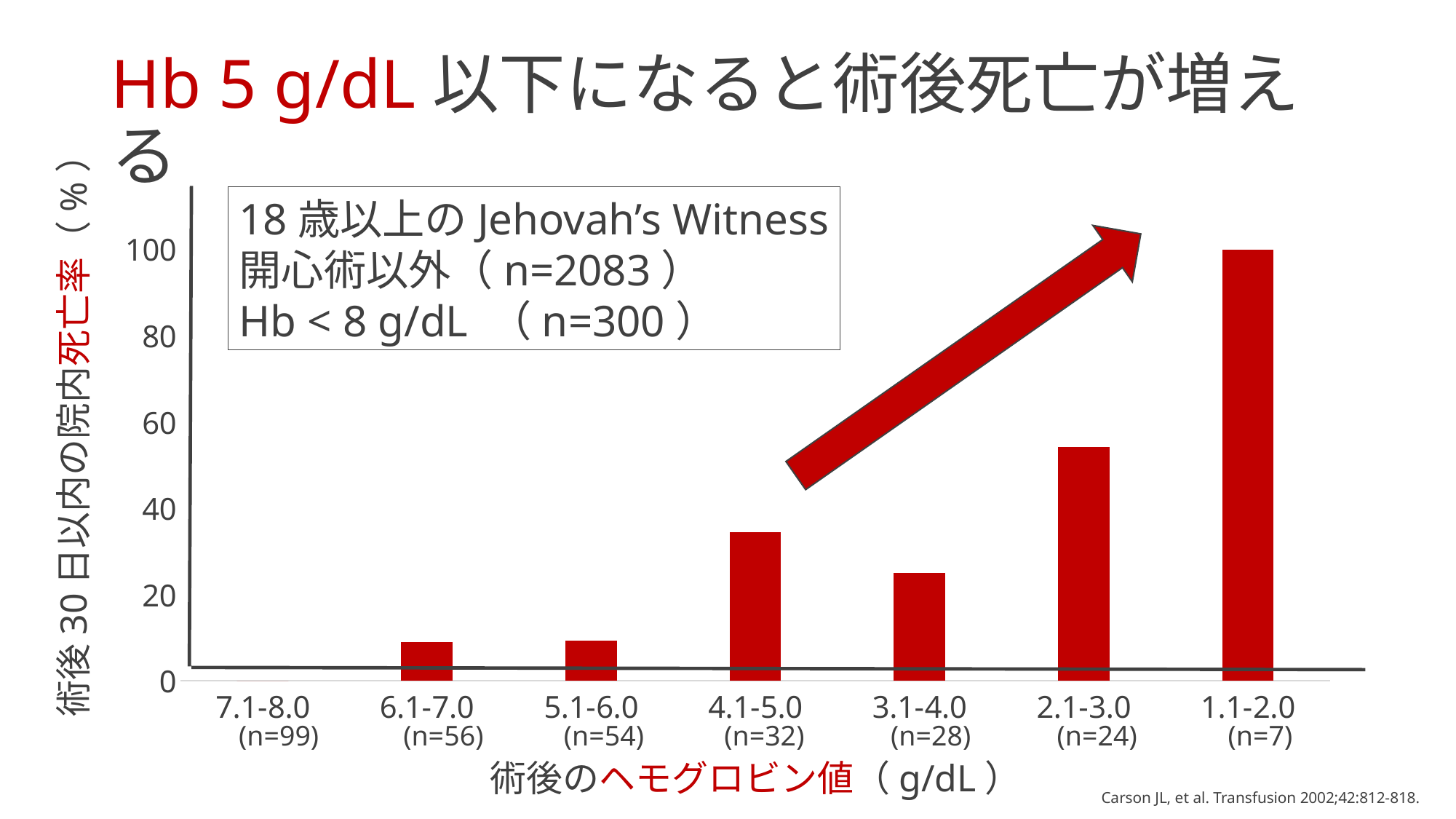
How many hemoglobin categories are shown on the x axis? 7 Which hemoglobin category has the lowest mortality rate? 7.1-8.0 What is the mortality rate (%) for the 1.1-2.0 g/dL category? 100 Is the mortality rate for the 6.1-7.0 category greater or less than 20? less How many patients (n) are in the 1.1-2.0 g/dL category? n=7 Is the mortality rate for the 2.1-3.0 category greater or less than 40? greater Do the mortality rates generally rise or fall moving from left to right along the x axis? rise Which hemoglobin category has the highest mortality rate? 1.1-2.0 What kind of chart is shown on the slide? bar chart What is the source cited for the chart? Carson JL, et al. Transfusion 2002;42:812-818. Is the mortality rate for the 4.1-5.0 category greater or less than 40? less Which has the higher mortality rate, the 4.1-5.0 category or the 3.1-4.0 category? 4.1-5.0